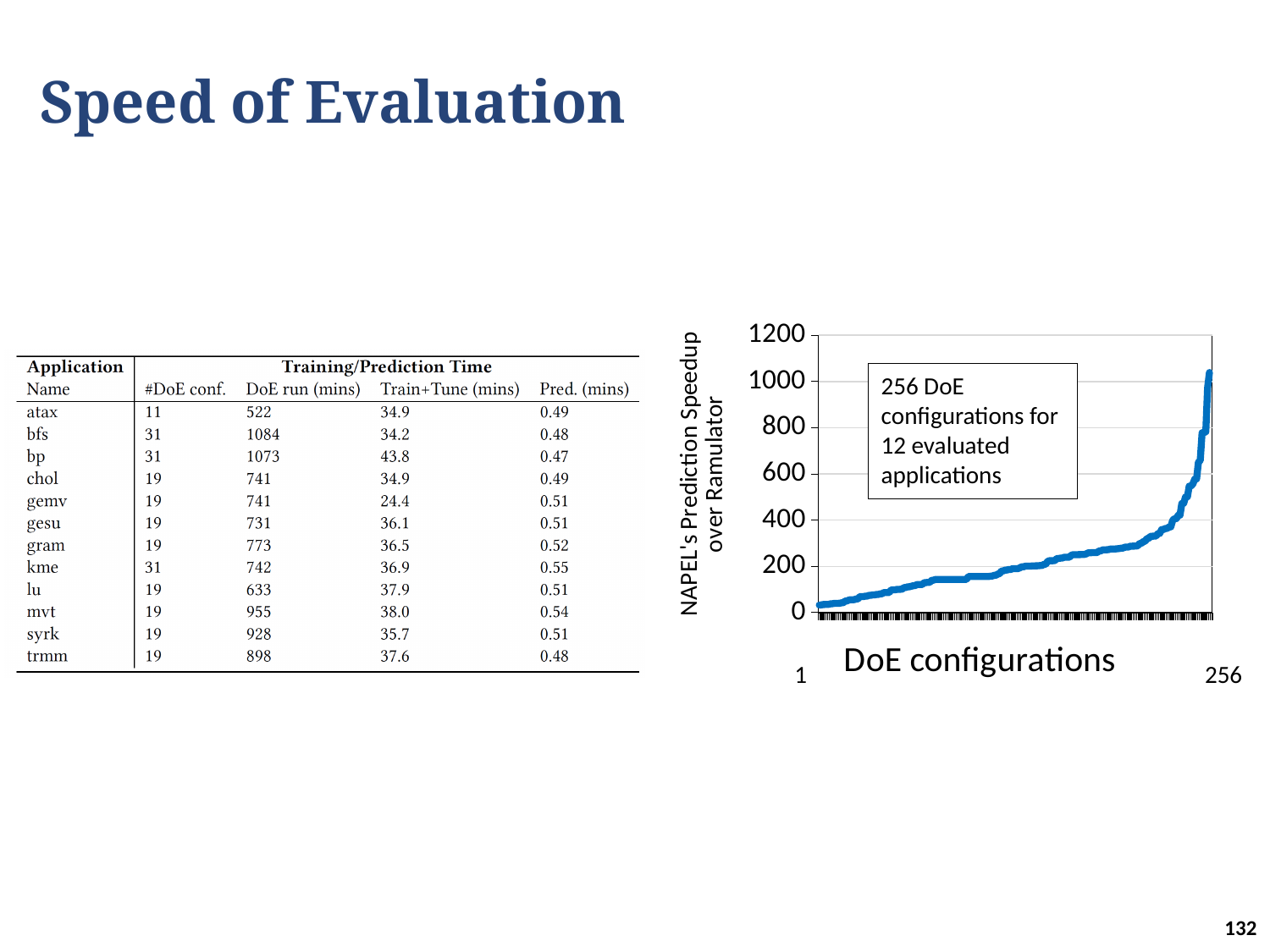
Is the speedup for the last DoE configuration (256) greater or less than 800? greater Is the speedup for the first DoE configuration (1) greater or less than 200? less Do the values in the chart rise or fall as you move from configuration 1 to configuration 256 along the x axis? rise According to the text box on the chart, how many evaluated applications do the 256 DoE configurations cover? 12 Which has the larger speedup in the chart: DoE configuration 1 or DoE configuration 256? 256 What is the label of the y axis of the chart? NAPEL's Prediction Speedup over Ramulator Is the speedup for the DoE configuration in the middle of the x axis greater or less than 400? less How many DoE configurations are plotted in the chart? 256 What kind of chart is shown on the right of the slide? line chart Is the lowest speedup in the chart at the first or the last DoE configuration? first (1) Is the highest speedup in the chart at the first or the last DoE configuration? last (256)